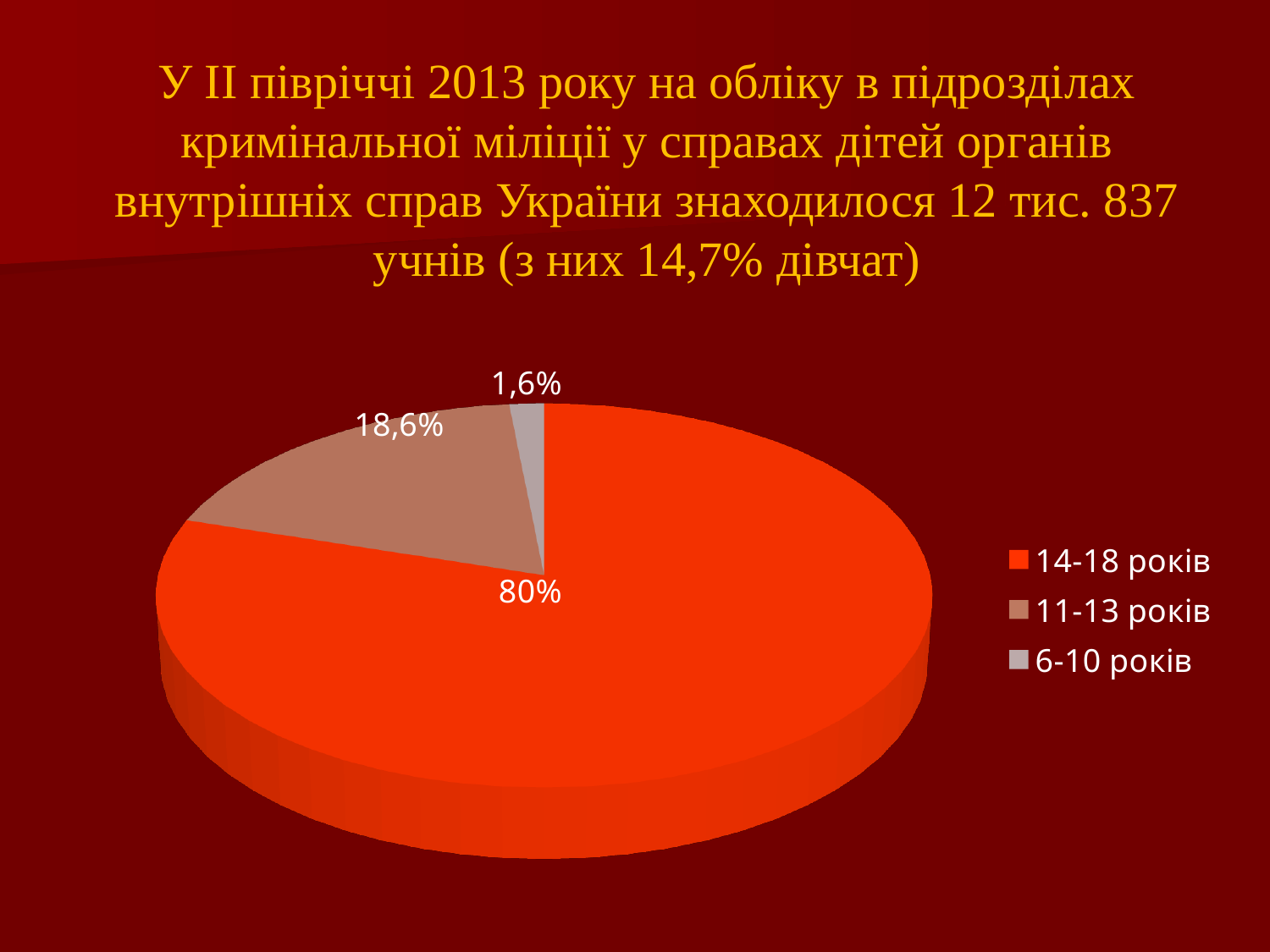
What share of the pie does the 14-18 років slice represent? 80% What kind of chart is shown on the slide? pie chart Which age group has the largest slice of the pie? 14-18 років What colour is the slice for 14-18 років? red Which age group has the smallest slice of the pie? 6-10 років What is the value shown for 6-10 років? 1,6% How many entries does the legend list? 3 What is the difference between the values for 11-13 років and 6-10 років? 17% What is the value shown for 11-13 років? 18,6% How many slices does the pie chart have? 3 Which is larger, the slice for 11-13 років or the slice for 6-10 років? 11-13 років Which legend entry is listed last? 6-10 років